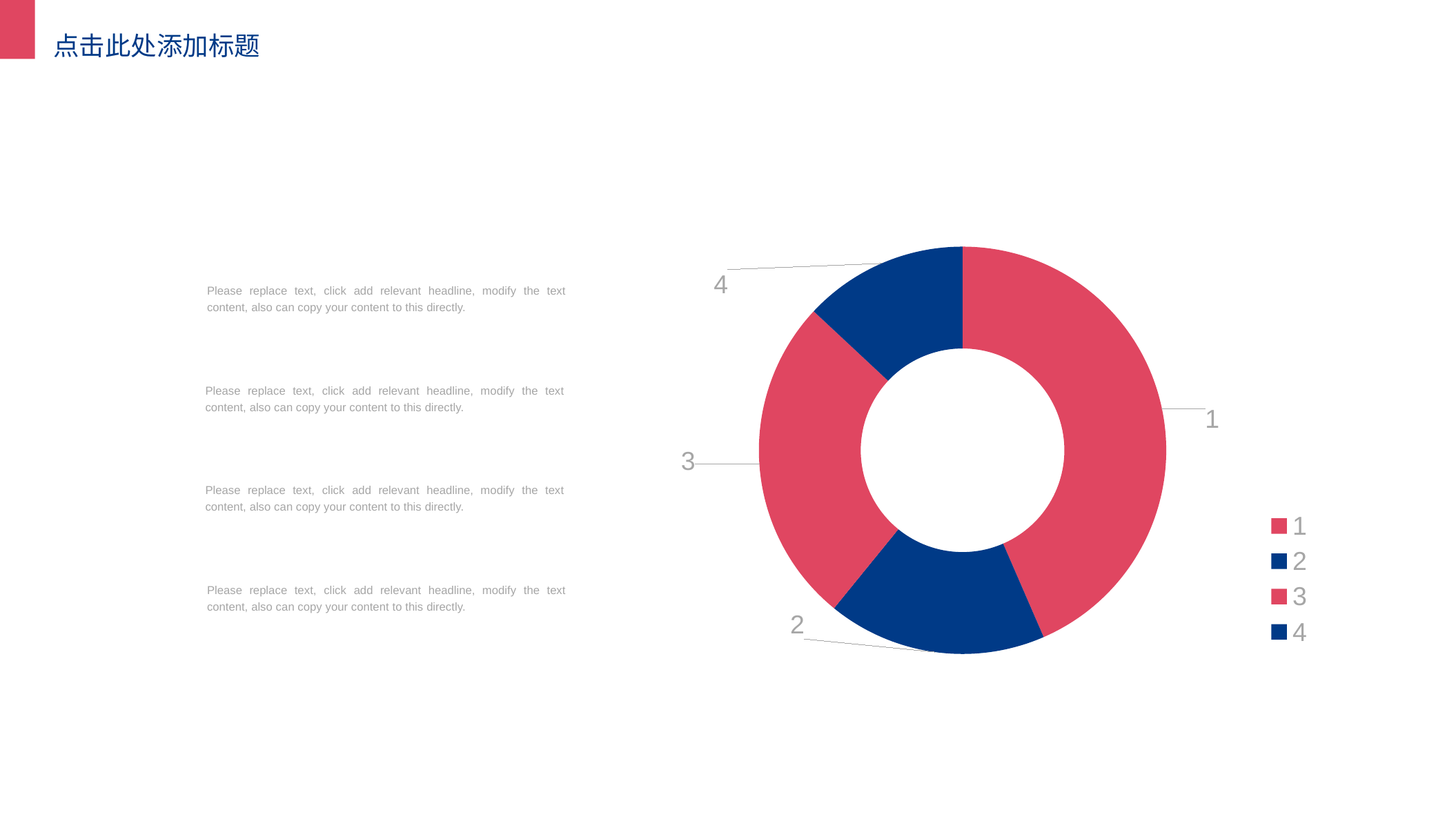
What colour is slice 1 in the doughnut chart? red How many entries does the chart legend list? 4 Which slice is larger, 1 or 2? 1 Which slice of the doughnut chart is the smallest? 4 What are the legend entries of the chart, in order? 1, 2, 3, 4 Which slice is larger, 1 or 4? 1 How many slices does the doughnut chart have? 4 Which slice of the doughnut chart is the largest? 1 Which slice is larger, 2 or 3? 3 What kind of chart is shown on the slide? doughnut chart